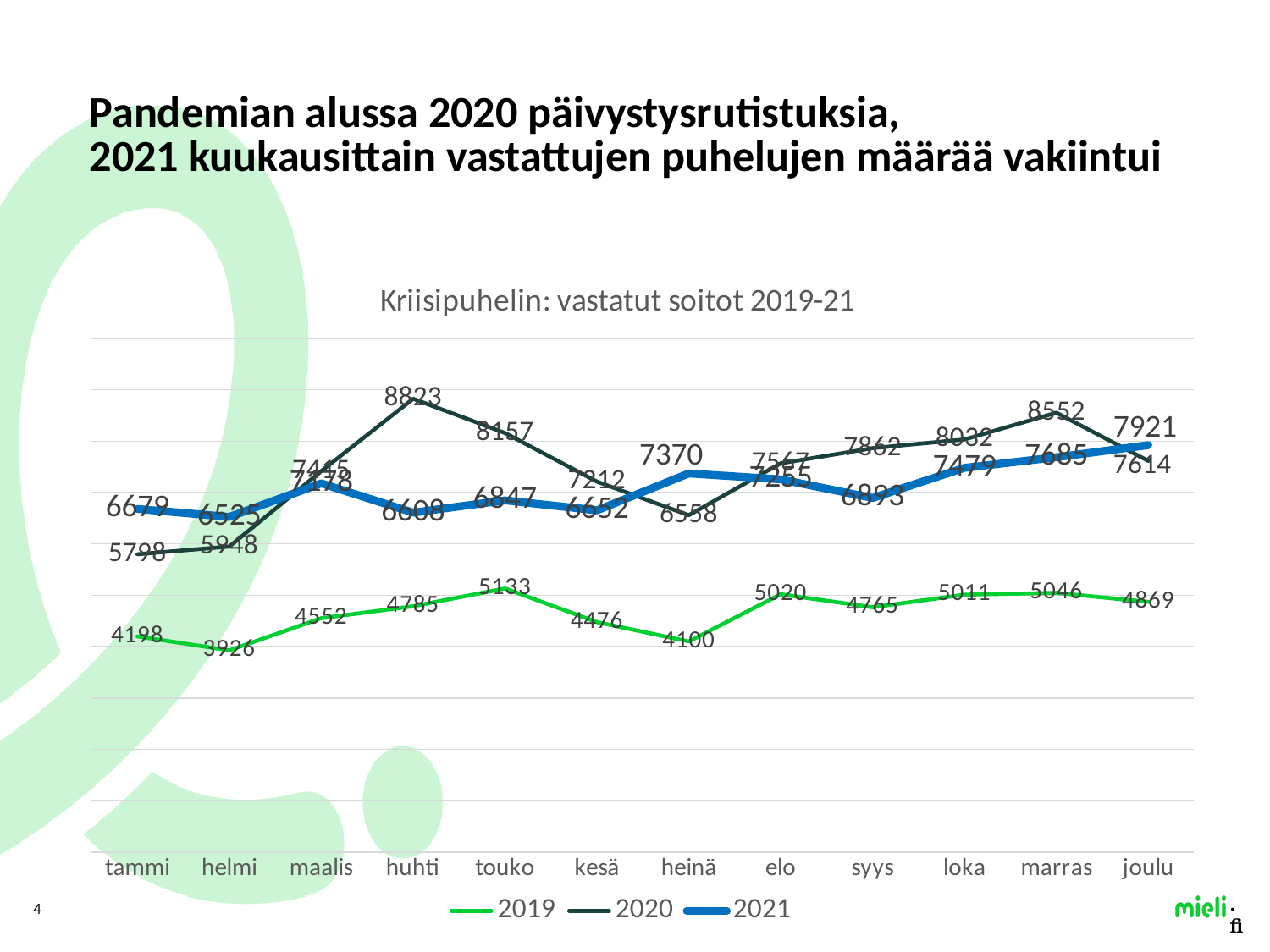
Does the 2019 series rise or fall from tammi to helmi? fall What is the title of the chart? Kriisipuhelin: vastatut soitot 2019-21 In which month does the 2019 series have its lowest value? helmi What is the value for 2020 in huhti? 8823 In heinä, which series has the larger value, 2020 or 2021? 2021 What is the value for 2021 in joulu? 7921 In which month does the 2020 series reach its highest value? huhti How many series does the legend list? 3 How many months are shown on the x axis? 12 What kind of chart is shown on the slide? line chart What is the difference between the 2020 and 2019 values in huhti? 4038 What is the value for 2019 in helmi? 3926